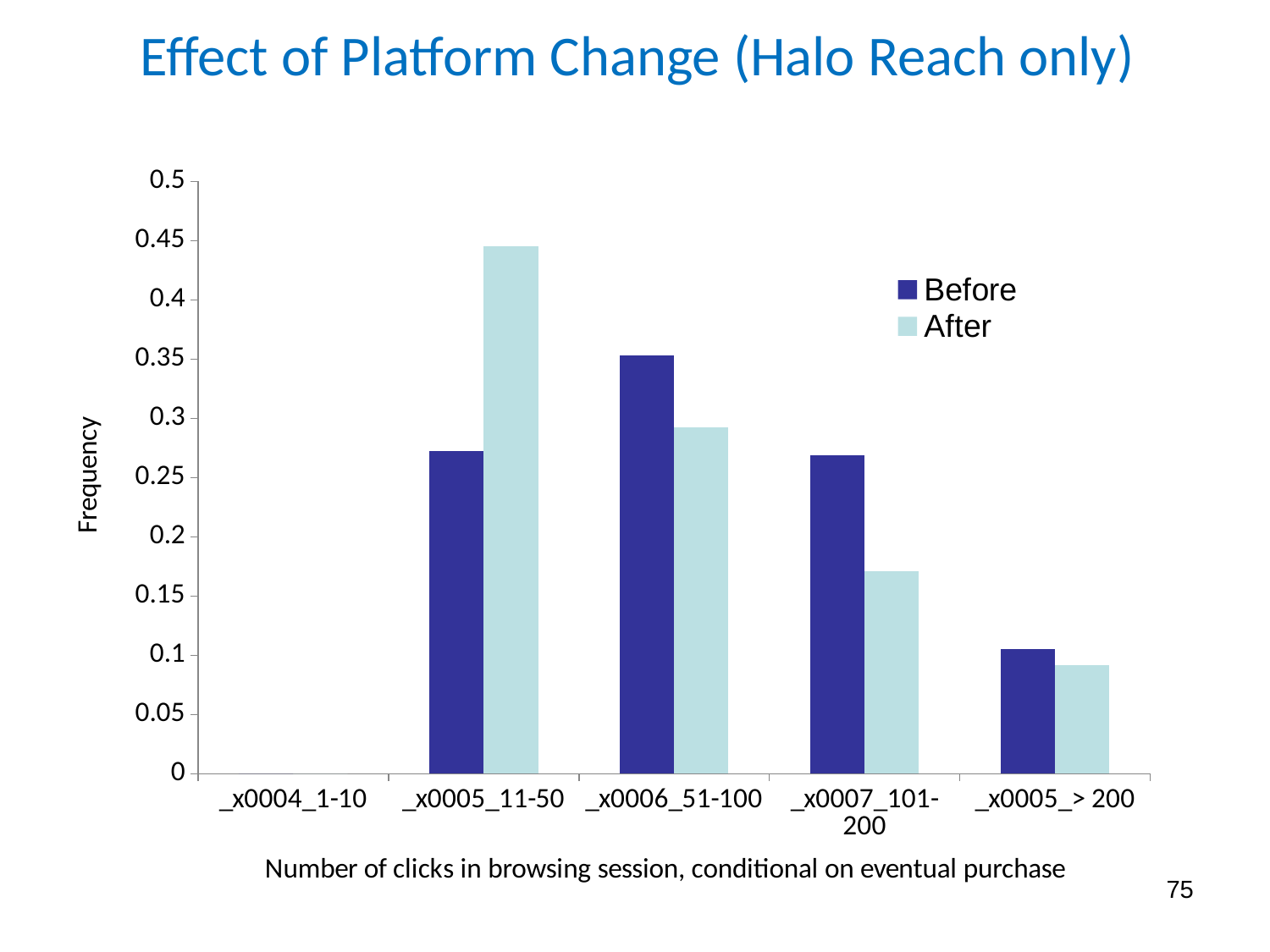
Is the After value for the 11-50 category greater or less than 0.4? greater How many series does the legend list? 2 For the 11-50 category, which is larger, the Before value or the After value? After Do the After values rise or fall from the 11-50 category to the > 200 category? fall Is the Before value for the 51-100 category greater or less than 0.3? greater How many categories are shown on the x axis? 5 Is the After value for the 101-200 category greater or less than 0.2? less What kind of chart is shown on the slide? bar chart Which category has the tallest After bar? _x0005_11-50 Which category has the tallest Before bar? _x0006_51-100 For the 51-100 category, which is larger, the Before value or the After value? Before